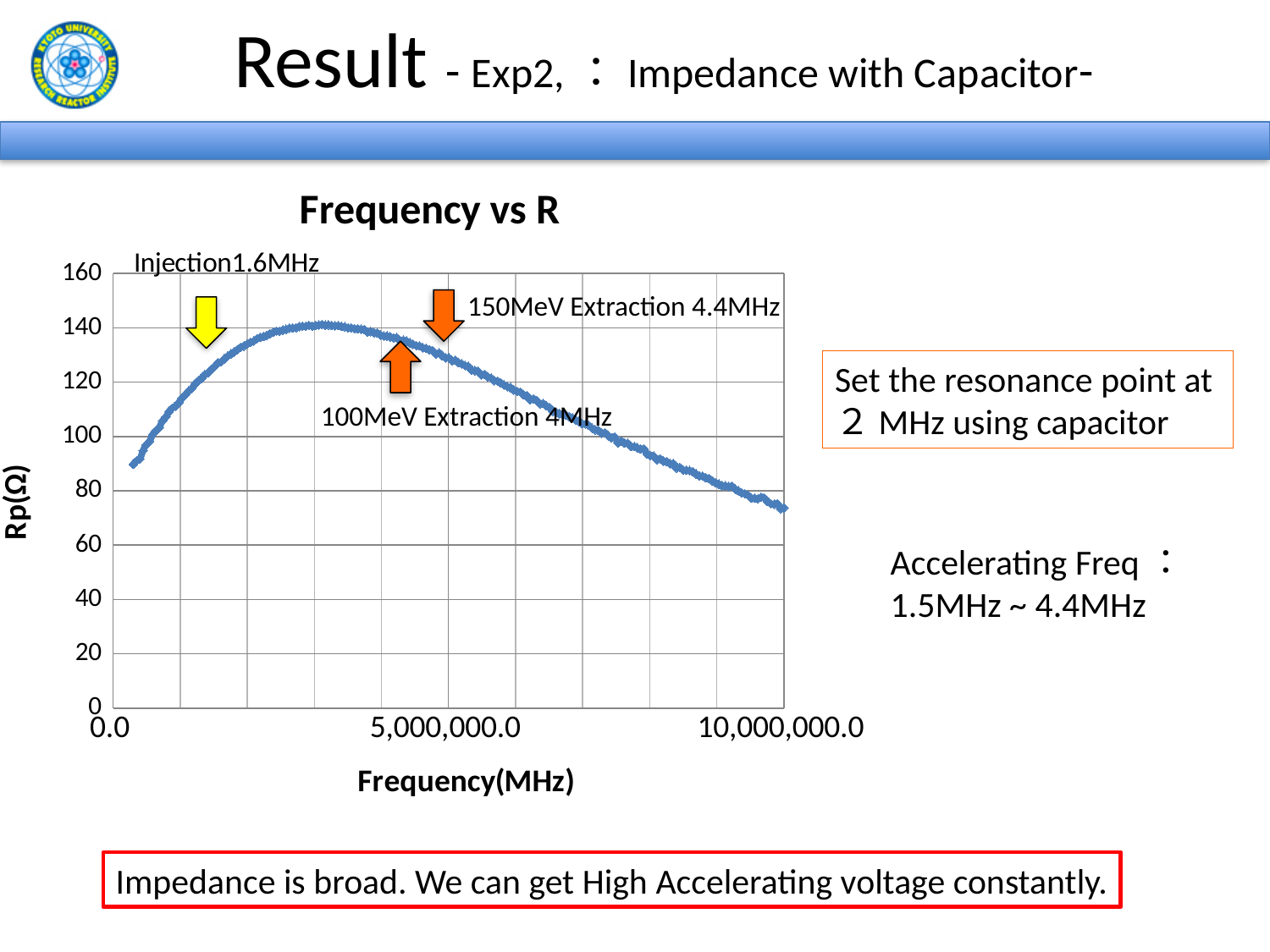
Is the value of Rp at a frequency of 10,000,000.0 greater or less than 80? less How does Rp change as frequency increases from 5,000,000.0 to 10,000,000.0? It falls What is the title of the chart? Frequency vs R Is the value of Rp at a frequency of 5,000,000.0 greater or less than 120? greater Is the value of Rp at the frequency marked '150MeV Extraction 4.4MHz' greater or less than the value at the frequency marked '100MeV Extraction 4MHz'? less How does Rp change as frequency increases from 0.0 toward about 3,500,000? It rises Is the peak value of Rp on the chart greater or less than 120? greater What is the highest tick value shown on the vertical axis of the chart? 160 What is the label of the vertical axis of the chart? Rp(Ω) What kind of chart is shown on the slide? Scatter (line) chart